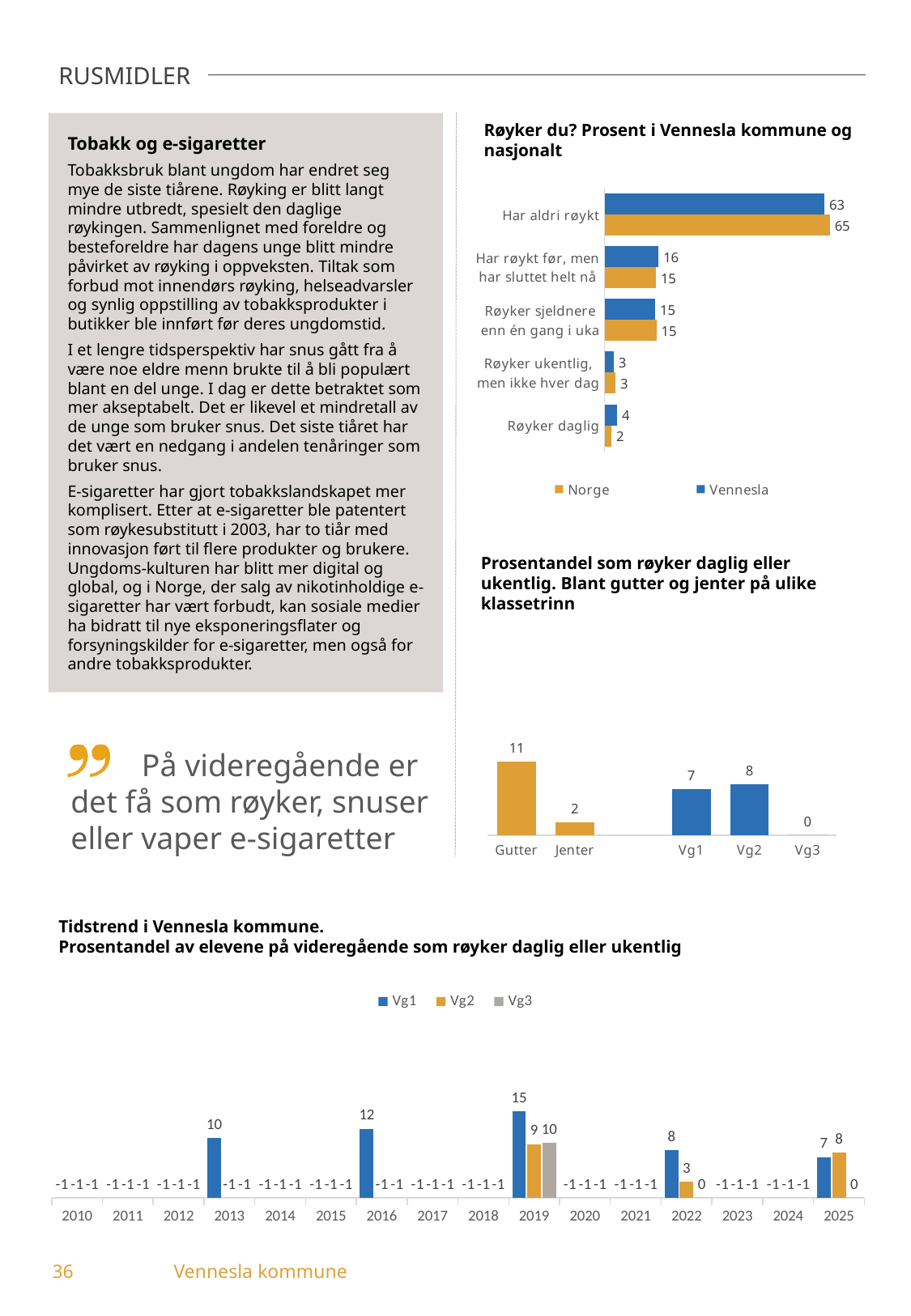
In the chart 'Prosentandel som røyker daglig eller ukentlig. Blant gutter og jenter på ulike klassetrinn', what is the value for Gutter? 11 In the chart 'Tidstrend i Vennesla kommune', what is the value for Vg3 in 2022? 0 In the chart 'Røyker du? Prosent i Vennesla kommune og nasjonalt', how many series does the legend list? 2 In the chart 'Røyker du? Prosent i Vennesla kommune og nasjonalt', what is the value for Norge for 'Røyker daglig'? 2 In the chart 'Tidstrend i Vennesla kommune', what is the value for Vg1 in 2019? 15 In the chart 'Røyker du? Prosent i Vennesla kommune og nasjonalt', what is the value for Vennesla for 'Har aldri røykt'? 63 In the chart 'Prosentandel som røyker daglig eller ukentlig. Blant gutter og jenter på ulike klassetrinn', which category has the lowest value? Vg3 In the chart 'Tidstrend i Vennesla kommune', which is larger in 2025, Vg1 or Vg2? Vg2 What kind of chart is 'Tidstrend i Vennesla kommune'? Bar chart In the chart 'Røyker du? Prosent i Vennesla kommune og nasjonalt', what is the difference between Vennesla and Norge for 'Røyker daglig'? 2 In the chart 'Røyker du? Prosent i Vennesla kommune og nasjonalt', which category has the highest value for Norge? Har aldri røykt In the chart 'Prosentandel som røyker daglig eller ukentlig. Blant gutter og jenter på ulike klassetrinn', what is the difference between Gutter and Jenter? 9